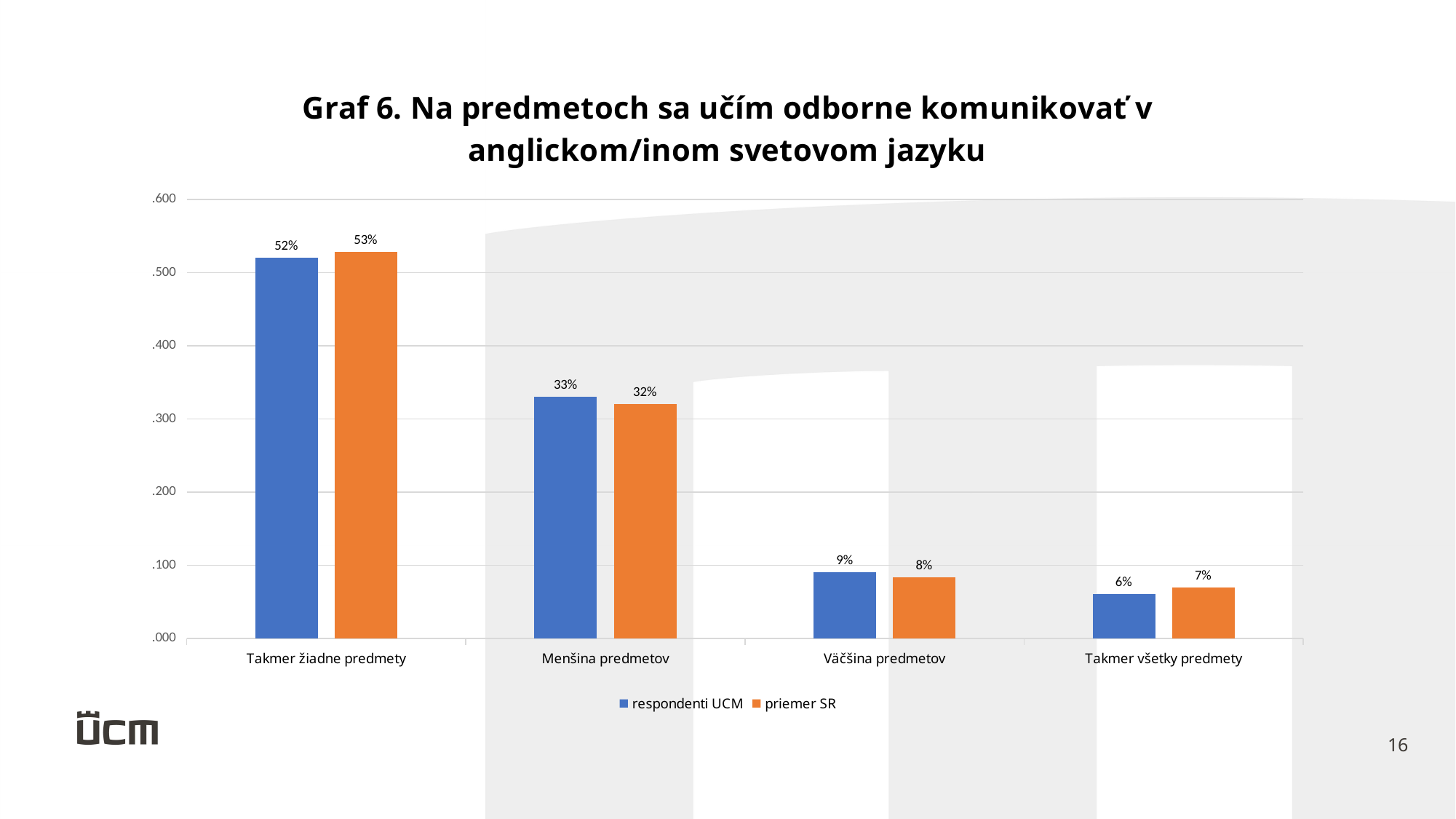
What is the value for priemer SR in the Menšina predmetov category? 32% What is the difference between the respondenti UCM and priemer SR values in the Menšina predmetov category? 1% How many categories are shown on the x axis? 4 Which category has the lowest value for respondenti UCM? Takmer všetky predmety In the Takmer žiadne predmety category, which series has the larger value: respondenti UCM or priemer SR? priemer SR What is the value for respondenti UCM in the Takmer žiadne predmety category? 52% What is the value for respondenti UCM in the Väčšina predmetov category? 9% Do the respondenti UCM values rise or fall from left to right along the x axis? fall How many series does the legend list? 2 What is the value for priemer SR in the Takmer všetky predmety category? 7% What kind of chart is shown on the slide? bar chart Which category has the highest value for priemer SR? Takmer žiadne predmety